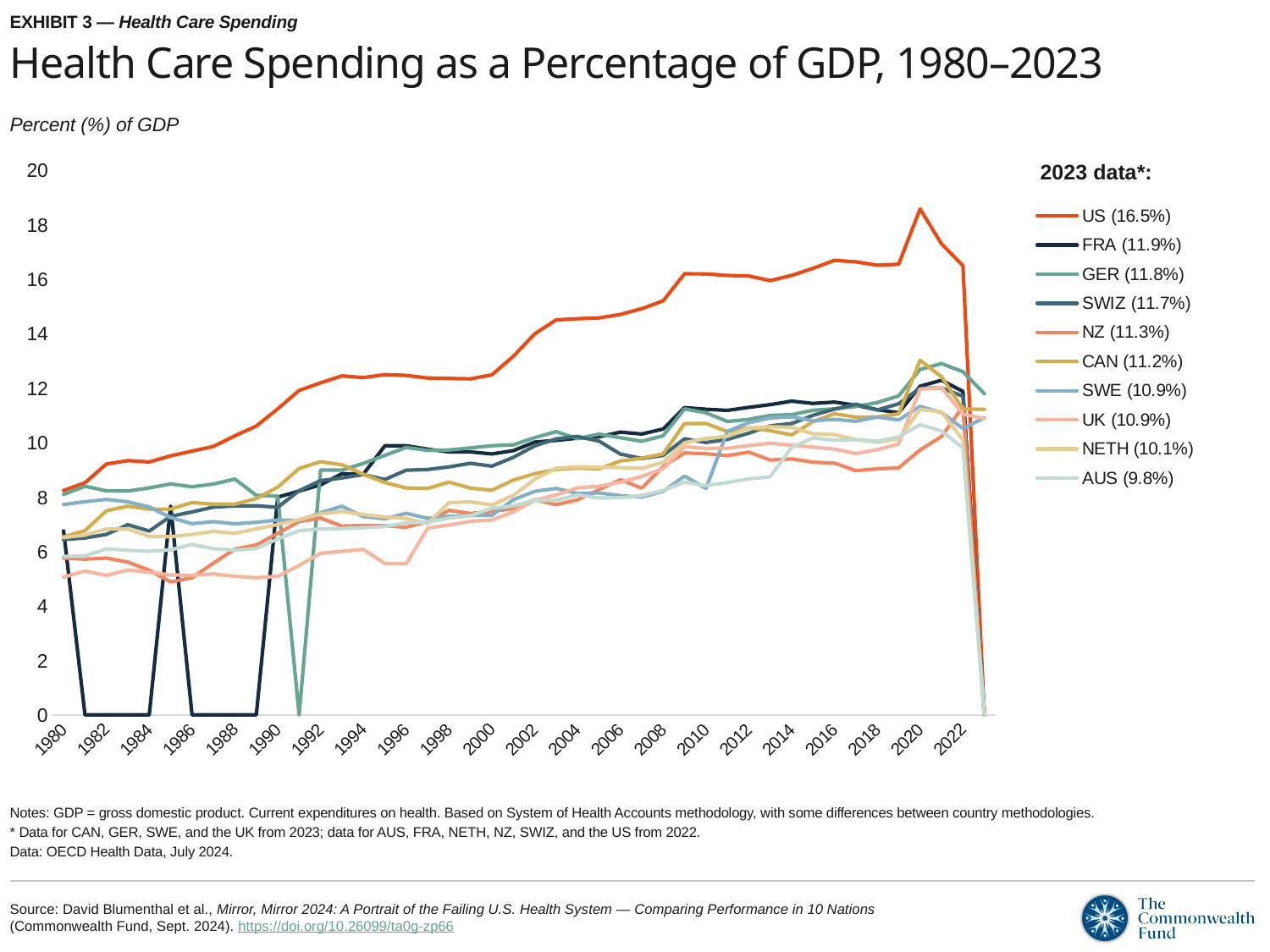
Is the US value at its 2020 peak greater or less than 18? greater Which has a higher 2023 value in the legend, Canada (CAN) or New Zealand (NZ)? NZ What is the difference between the 2023 values for the US and Australia (AUS) shown in the legend? 6.7 percentage points Does the US line generally rise or fall from 1980 to 2020? rise What kind of chart is shown on the slide? line chart According to the legend, what is the 2023 value for the Netherlands (NETH)? 10.1% According to the legend, what is the 2023 value for Germany (GER)? 11.8% Which country has the lowest 2023 value in the legend? AUS According to the legend, what is the 2023 health care spending value for the US? 16.5% How many countries does the legend list? 10 What is the title of the chart? Health Care Spending as a Percentage of GDP, 1980–2023 Which country has the highest 2023 value in the legend? US